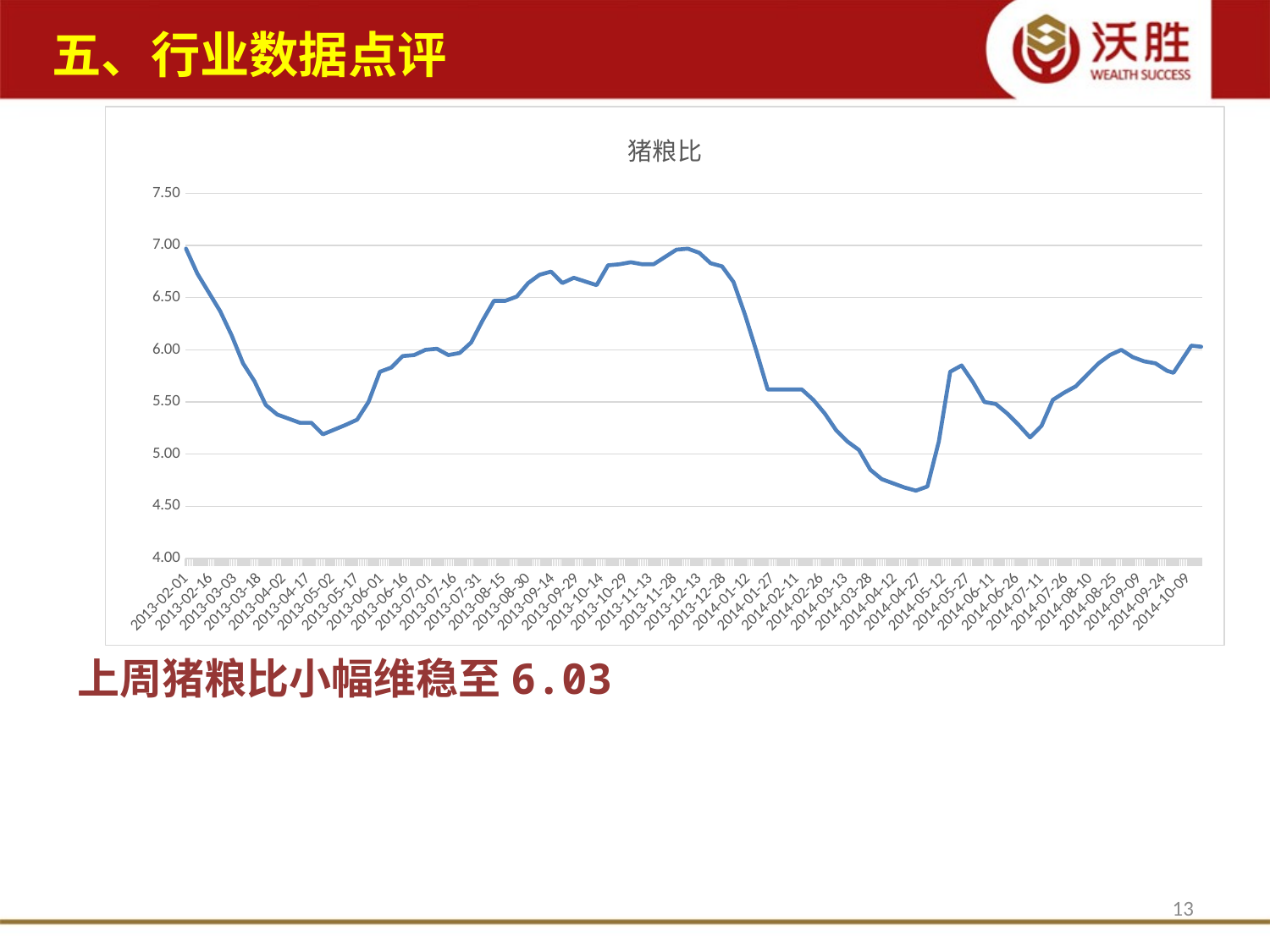
Does the value rise or fall between 2014-07-11 and 2014-10-09? rise Which date has the larger value, 2013-02-01 or 2014-04-27? 2013-02-01 Does the value rise or fall between 2013-02-01 and 2013-05-02? fall Is the value for 2014-04-27 greater or less than 5.00? less Is the value for 2013-02-01 greater or less than 6.50? greater Is the value for 2013-12-13 greater or less than 6.50? greater What kind of chart is shown on the slide? line chart What is the title of the chart? 猪粮比 According to the slide text, what was the 猪粮比 value last week (the final point on the chart)? 6.03 What is the highest value shown on the vertical axis of the chart? 7.50